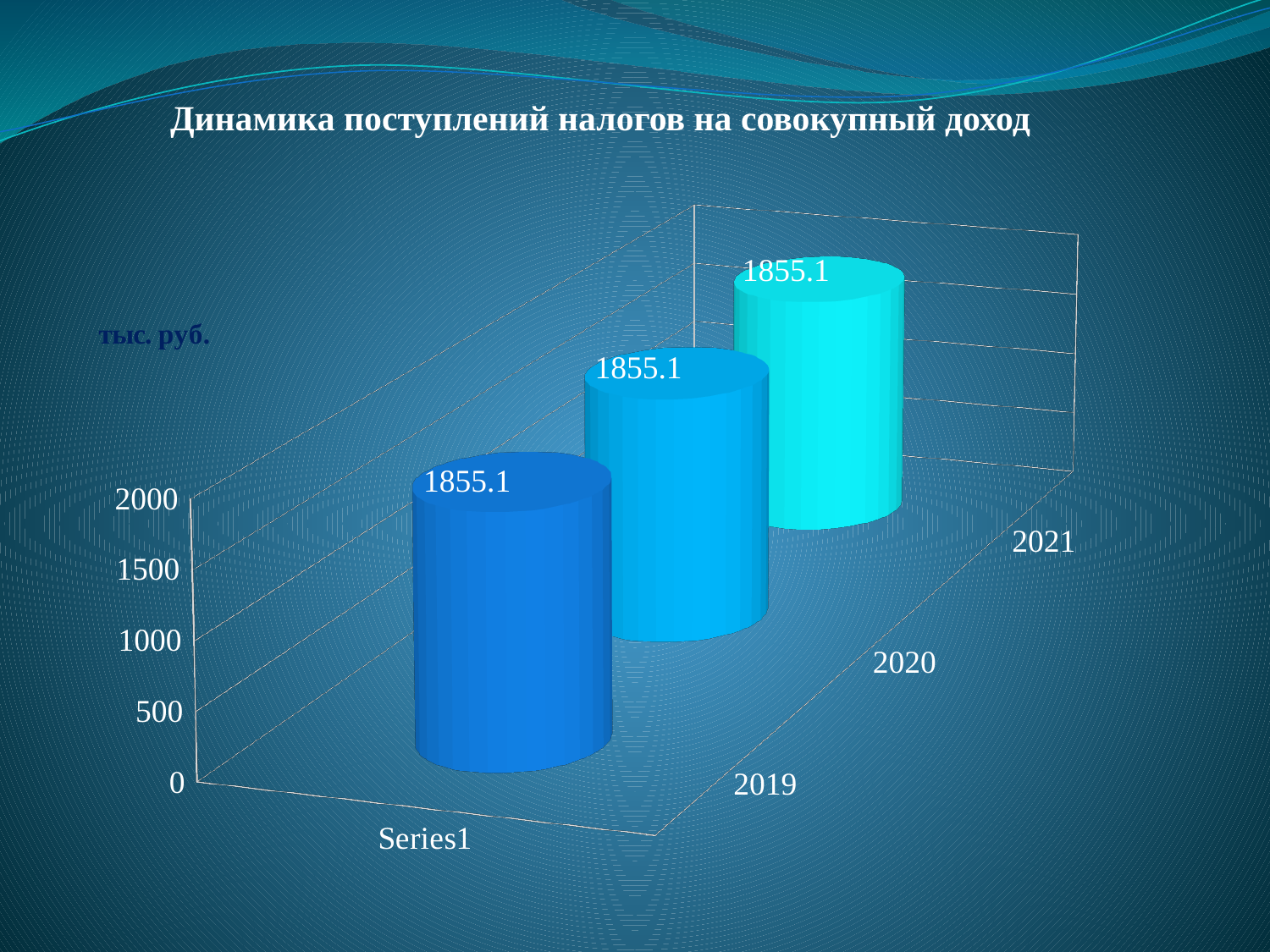
Do the values rise, fall, or stay the same from 2019 to 2021? stay the same Is the value for 2020 greater or less than 1500? greater What is the highest tick value shown on the vertical axis? 2000 What is the title of the chart? Динамика поступлений налогов на совокупный доход What kind of chart is shown on the slide? bar chart Is the value for 2021 greater or less than 2000? less What is the value for 2020? 1855.1 How many categories (years) are shown on the chart? 3 What is the difference between the values for 2021 and 2019? 0 What is the value for 2019? 1855.1 What is the value for 2021? 1855.1 What unit is indicated for the values on the chart? тыс. руб.